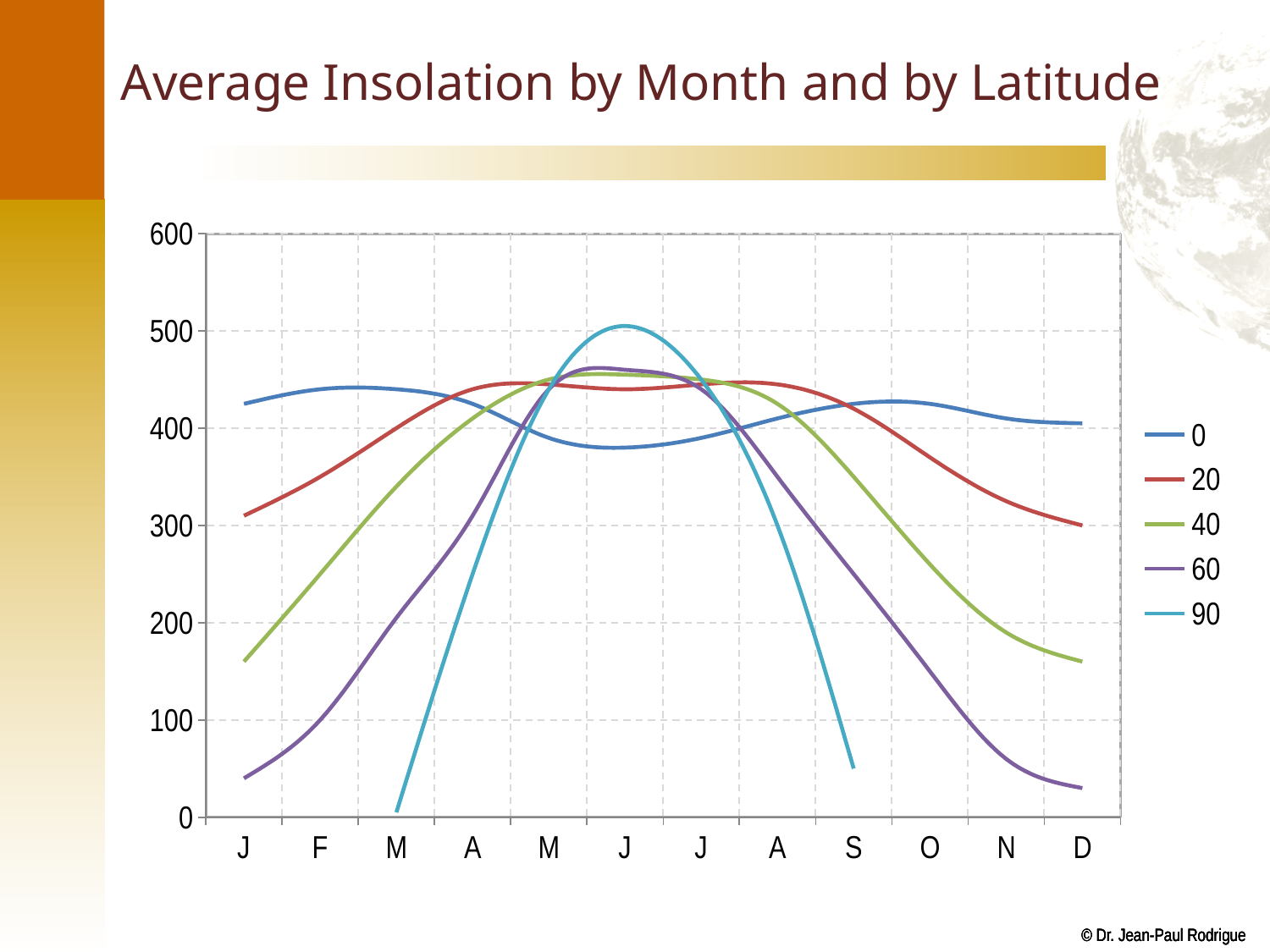
Is the value for the 20 series in January greater or less than 400? less How many series does the legend list? 5 Which series reaches the highest peak value on the chart? 90 Is the value for the 60 series in January greater or less than 100? less Is the value for the 40 series in December greater or less than 200? less In January, which series has the higher value, 0 or 20? 0 What kind of chart is shown on the slide? line chart Which latitude series is drawn in red? 20 How many months are shown along the x axis? 12 Does the 60 series rise or fall from January to June? rise What is the title of the chart? Average Insolation by Month and by Latitude